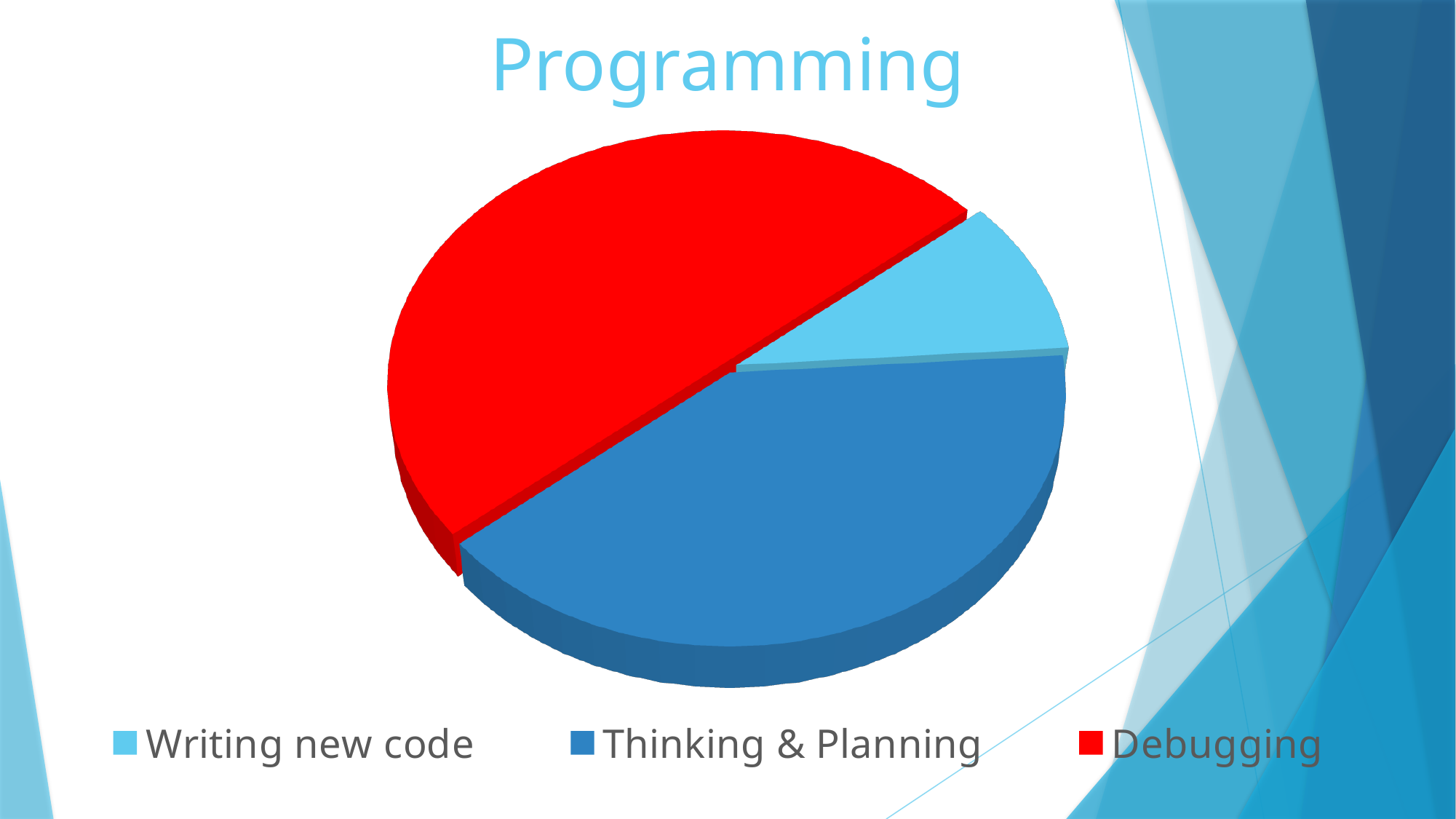
What is the title of the chart? Programming What colour is the Debugging slice? red Which category has the largest slice of the pie? Debugging Which slice is larger, Debugging or Writing new code? Debugging What kind of chart is shown on the slide? pie chart Which category has the smallest slice of the pie? Writing new code How many entries does the legend list? 3 Which slice is larger, Thinking & Planning or Writing new code? Thinking & Planning Which slice is larger, Debugging or Thinking & Planning? Debugging How many slices does the pie chart have? 3